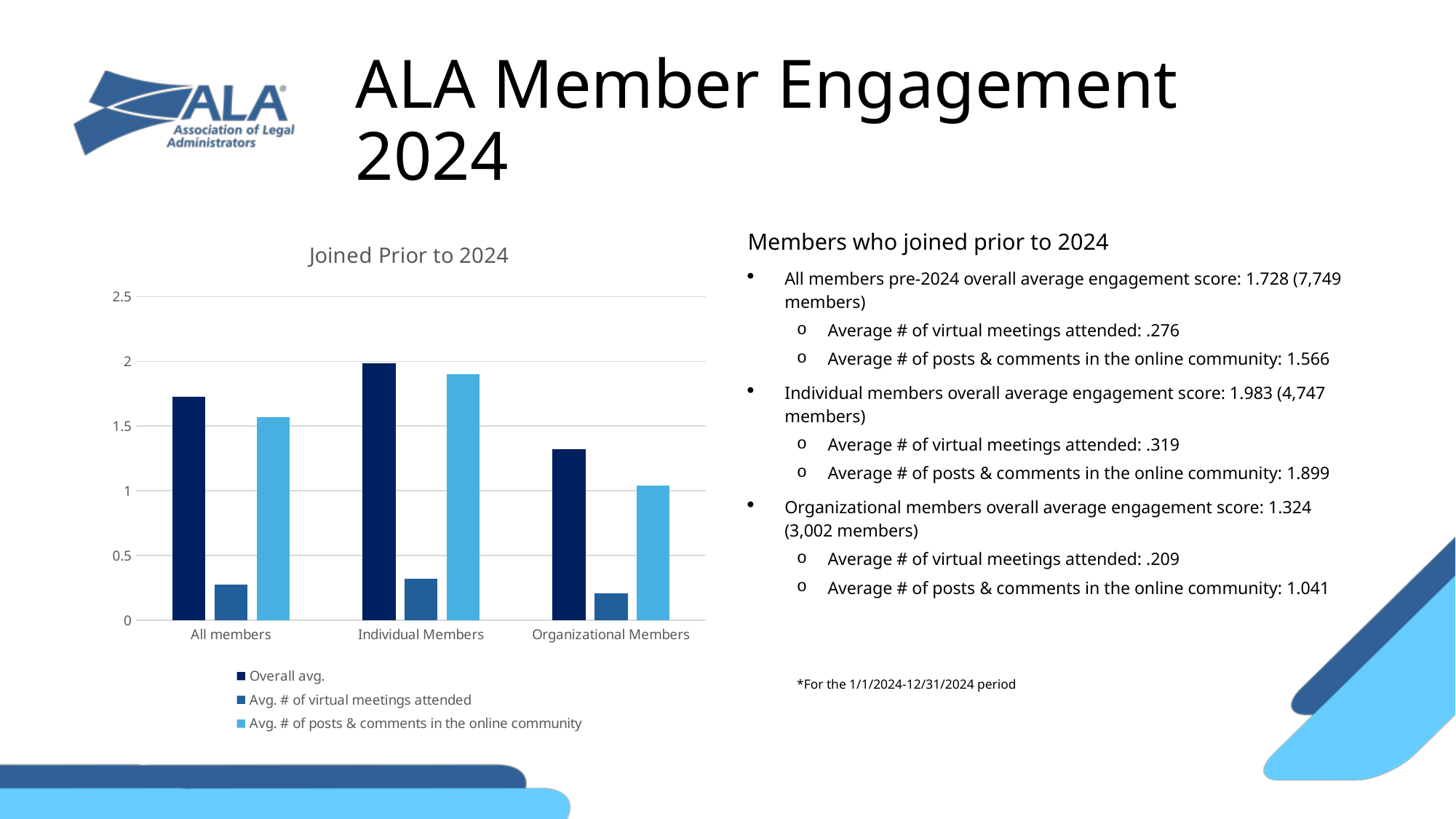
According to the slide, what is the overall average engagement score for Individual Members? 1.983 Which is larger: the Overall avg. for All members or for Organizational Members? All members Which category has the lowest bar for Avg. # of virtual meetings attended? Organizational Members According to the slide, what is the average number of virtual meetings attended by Organizational Members? .209 Is the Avg. # of posts & comments in the online community for Organizational Members greater or less than 1.5? less Which is larger: the Avg. # of posts & comments in the online community for All members or for Individual Members? Individual Members How many series does the chart's legend list? 3 What kind of chart is shown on the slide? bar chart How many categories are shown on the x axis of the chart? 3 What is the title of the chart? Joined Prior to 2024 Which category has the highest Overall avg. bar? Individual Members Is the Overall avg. value for Individual Members greater or less than 1.5? greater